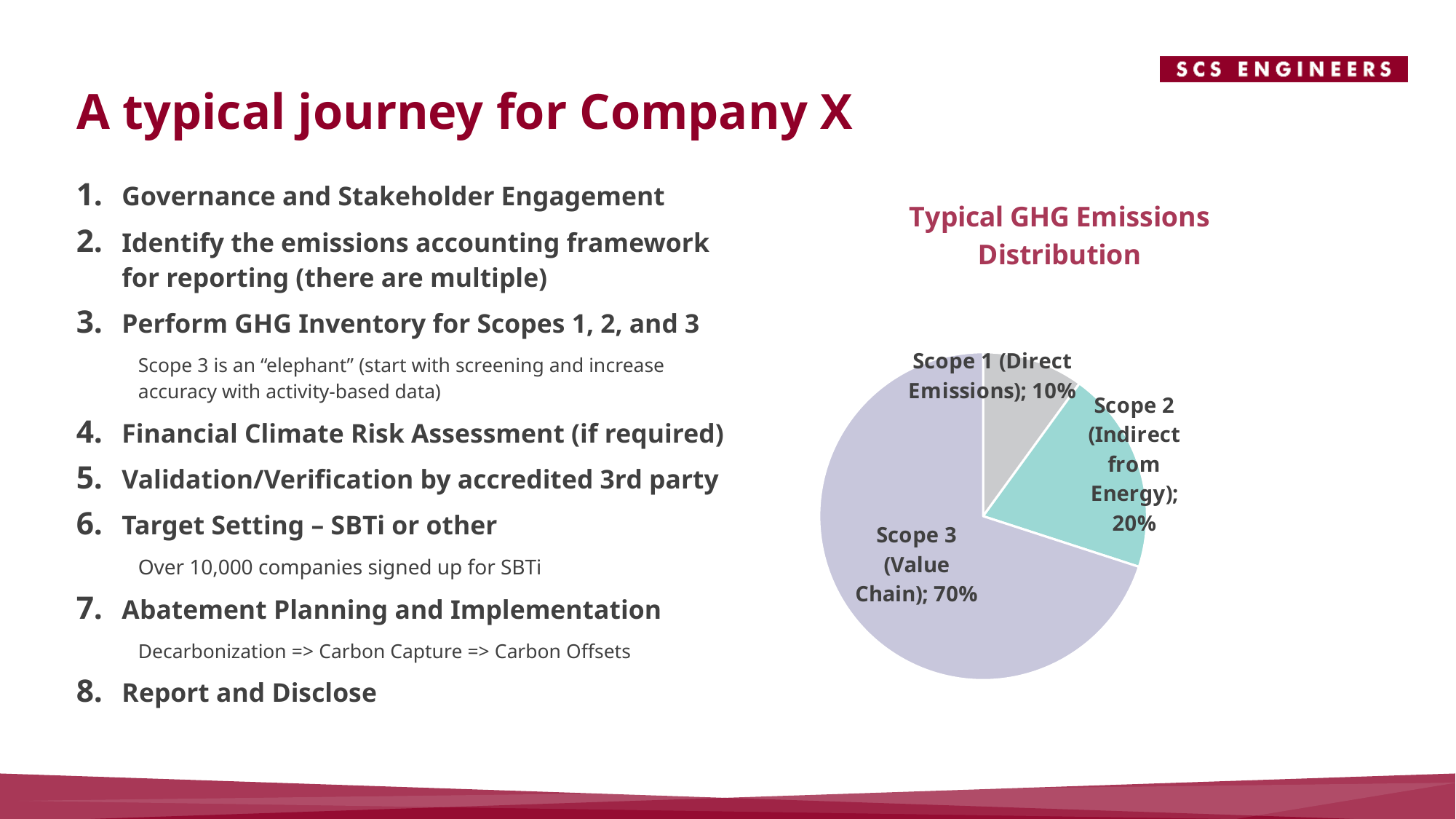
Which scope has the largest share of the pie? Scope 3 (Value Chain) How many slices does the pie chart have? 3 What share of emissions does Scope 1 (Direct Emissions) account for? 10% What is the title of the chart? Typical GHG Emissions Distribution Which is larger, the share for Scope 2 or the share for Scope 1? Scope 2 Which scope has the smallest share of the pie? Scope 1 (Direct Emissions) What is the difference in percentage points between Scope 3 and Scope 2? 50 What is the difference in percentage points between Scope 2 and Scope 1? 10 What colour is the Scope 2 (Indirect from Energy) slice? Teal What kind of chart is shown on the slide? Pie chart What share of emissions does Scope 2 (Indirect from Energy) account for? 20% What share of emissions does Scope 3 (Value Chain) account for? 70%